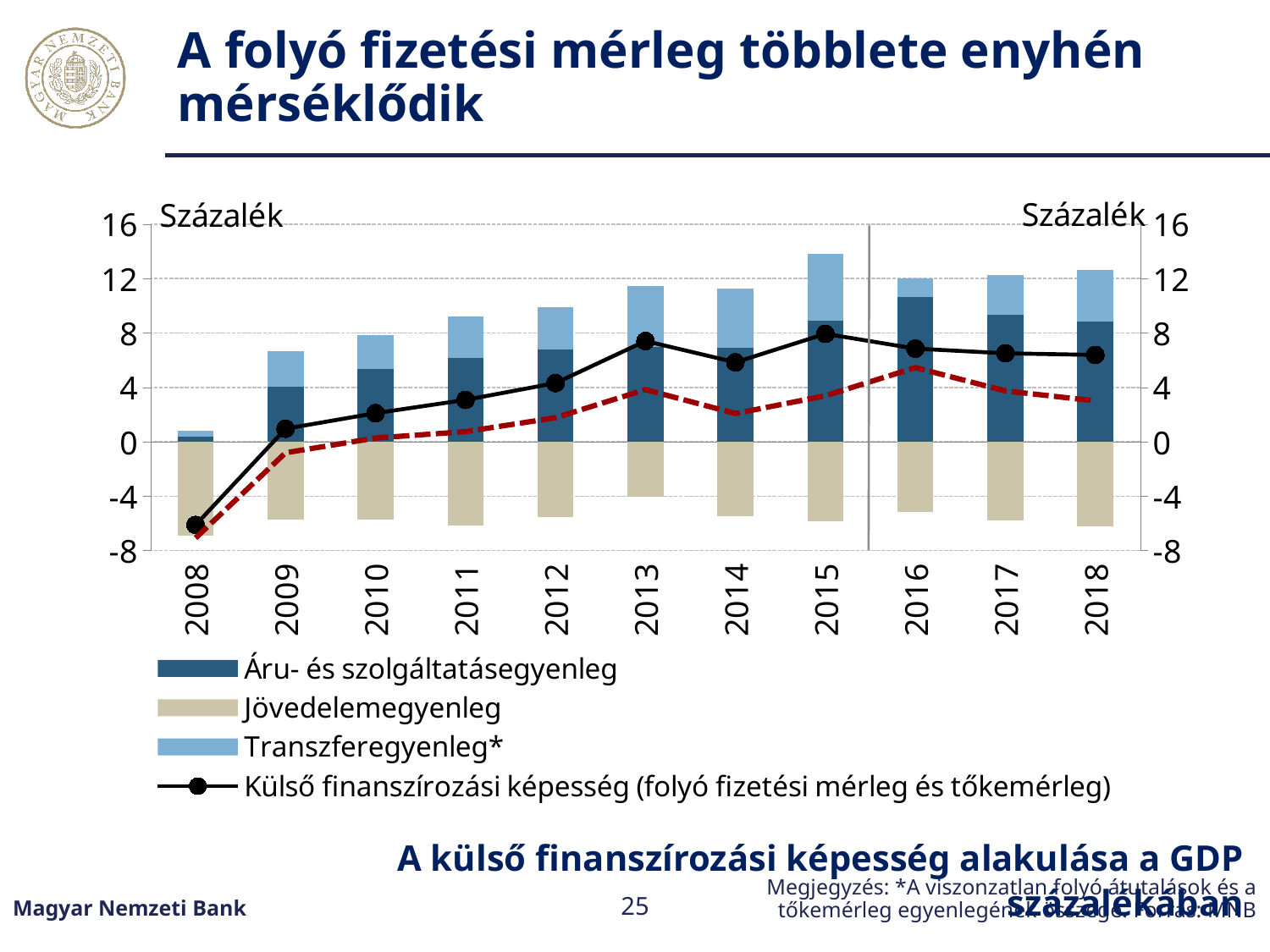
Is the Áru- és szolgáltatásegyenleg segment in 2008 greater or less than 4? less Does the Külső finanszírozási képesség line rise or fall from 2008 to 2015? rise Is the value of Külső finanszírozási képesség in 2008 greater or less than -4? less How many years are shown on the x axis of the chart? 11 In which year is the Transzferegyenleg* segment the largest? 2015 Which is larger, the Külső finanszírozási képesség value in 2009 or in 2013? 2013 What unit label is shown at the top of the vertical axes? Százalék Which year has the lowest value for Külső finanszírozási képesség (the black line)? 2008 What kind of chart is shown on the slide? Bar chart (stacked bars with lines) Is the Áru- és szolgáltatásegyenleg segment in 2016 greater or less than 8? greater How many series does the chart legend list? 4